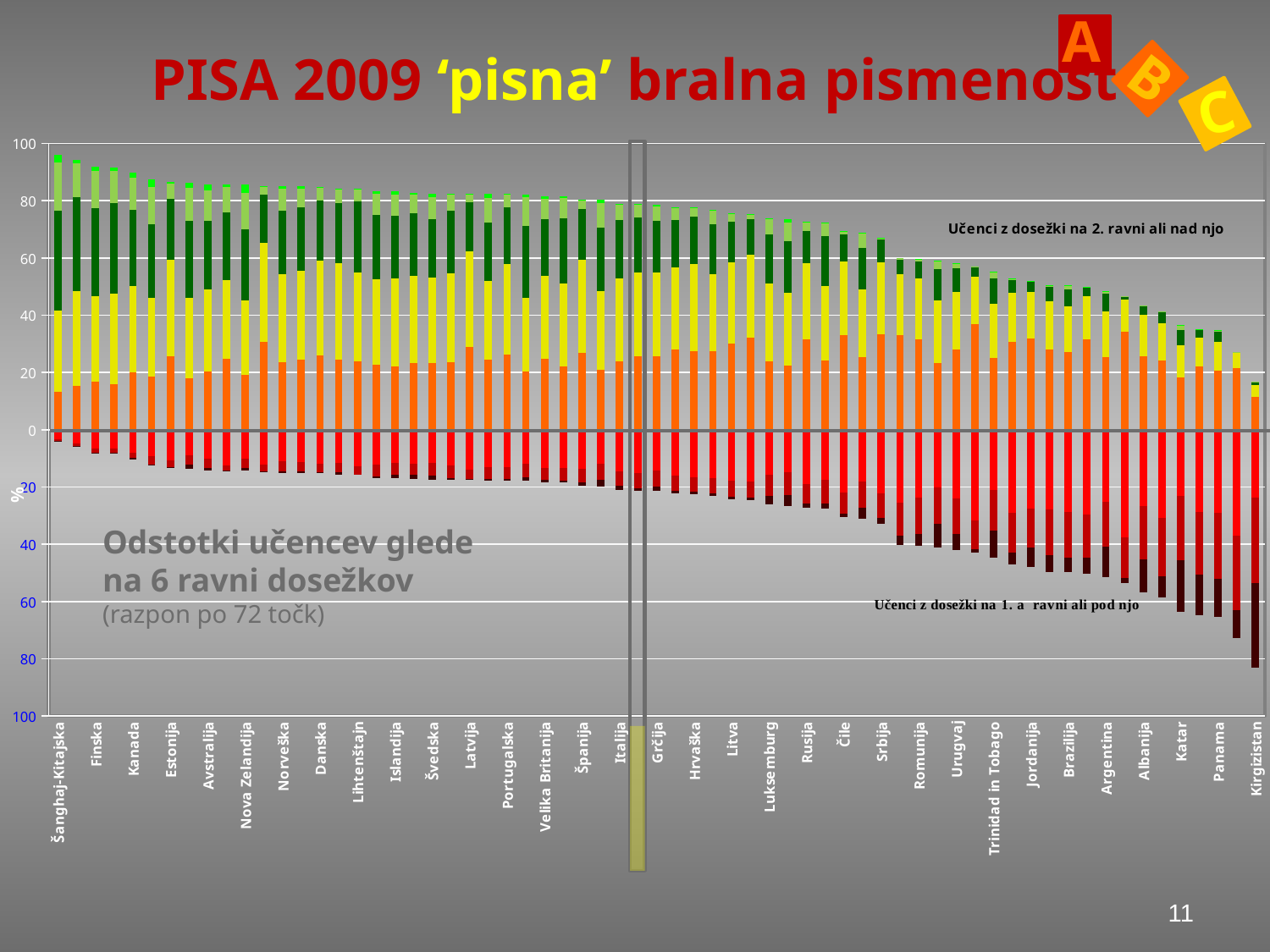
Is the share of students at level 1a or below for Kirgizistan (the portion below 0) greater or less than 60? greater Is the share of students at level 2 or above for Panama greater or less than 40? less Which country has the tallest stack of students at level 2 or above (the portion above 0)? Šanghaj-Kitajska Is the share of students at level 2 or above for Kirgizistan greater or less than 20? less Which country has the smallest share of students at level 2 or above (the portion above 0)? Kirgizistan What kind of chart is shown on the slide? stacked bar chart Which country has a larger share of students at level 1a or below (the portion below 0), Šanghaj-Kitajska or Panama? Panama What is the title of the slide? PISA 2009 'pisna' bralna pismenost Do the shares of students at level 2 or above rise or fall from left to right along the x axis? fall Which country has a larger share of students at level 2 or above, Finska or Kirgizistan? Finska